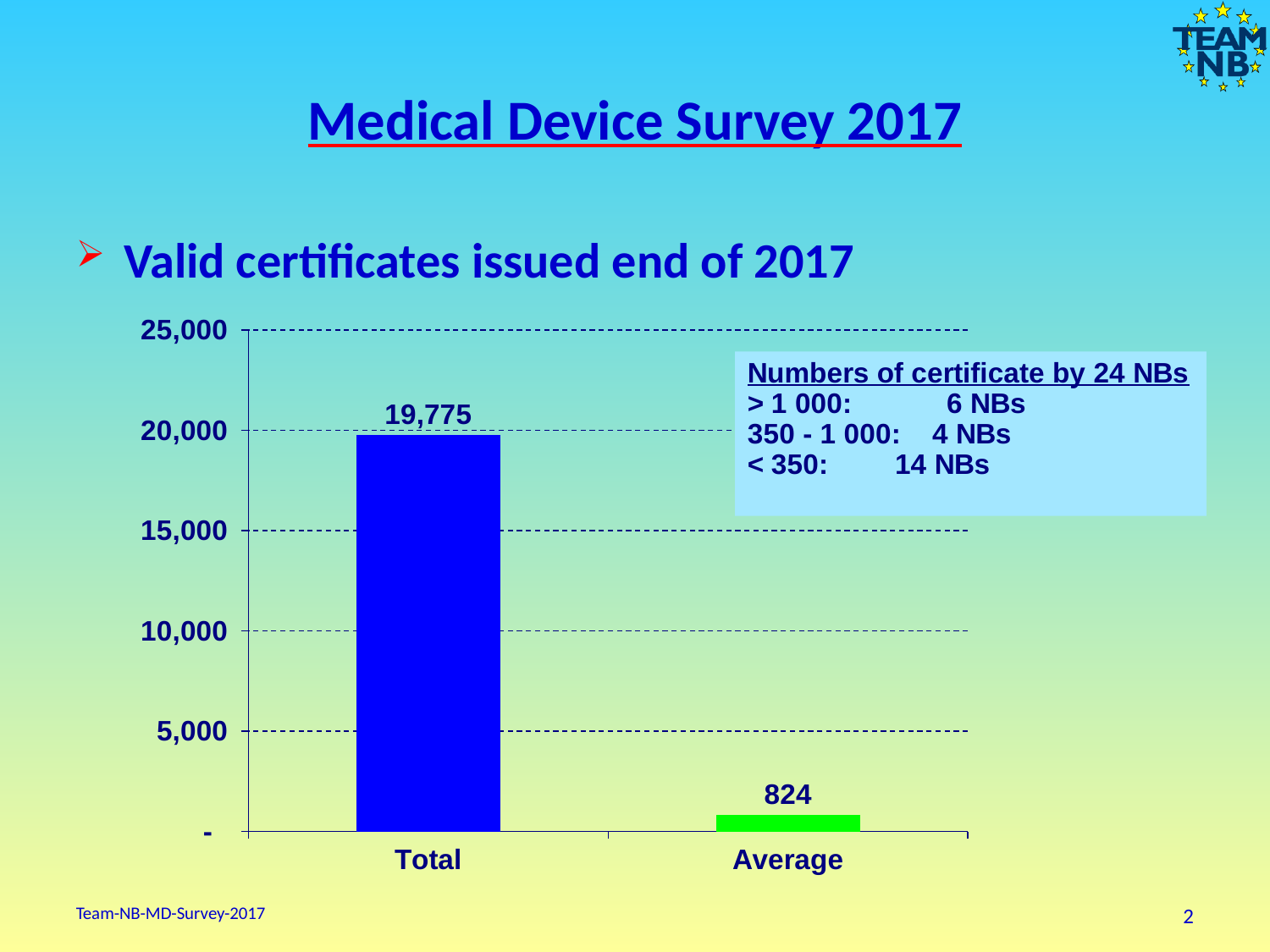
What is the difference between the Total and Average values? 18,951 Which is larger, the Total value or the Average value? Total Which category has the highest value? Total Is the value for Average greater or less than 5,000? less What kind of chart is shown on the slide? bar chart Which category has the lowest value? Average What is the maximum value shown on the y axis? 25,000 What colour is the Average bar? green How many categories are shown on the x axis? 2 What is the value of the Total bar? 19,775 What is the value of the Average bar? 824 Is the value for Total greater or less than 15,000? greater